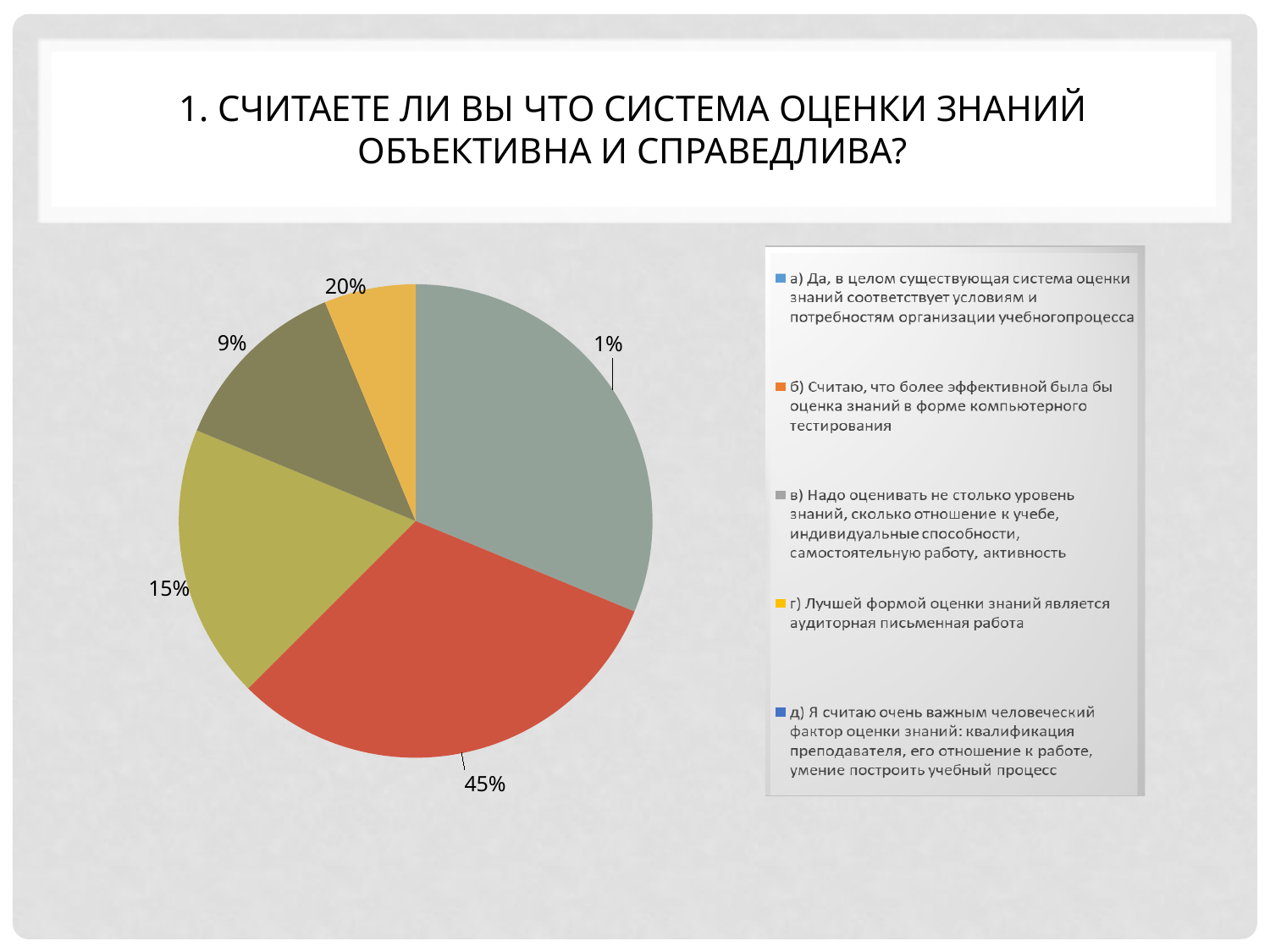
How many slices does the pie chart have? 5 What is the smallest percentage label printed on the pie chart? 1% What percentage label is attached to the light olive-green slice on the left of the pie chart? 15% What is the title of the slide containing the pie chart? 1. СЧИТАЕТЕ ЛИ ВЫ ЧТО СИСТЕМА ОЦЕНКИ ЗНАНИЙ ОБЪЕКТИВНА И СПРАВЕДЛИВА? What percentage label is attached to the yellow slice at the top of the pie chart? 20% What kind of chart is shown on the slide? pie chart What percentage label is attached to the dark olive slice in the upper left of the pie chart? 9% What is the largest percentage label printed on the pie chart? 45% What is the difference between the 45% label and the 20% label on the pie chart? 25% What percentage label is attached to the red slice of the pie chart? 45% What percentage label is attached to the grey-green slice on the right of the pie chart? 1% How many entries does the legend of the pie chart list? 5